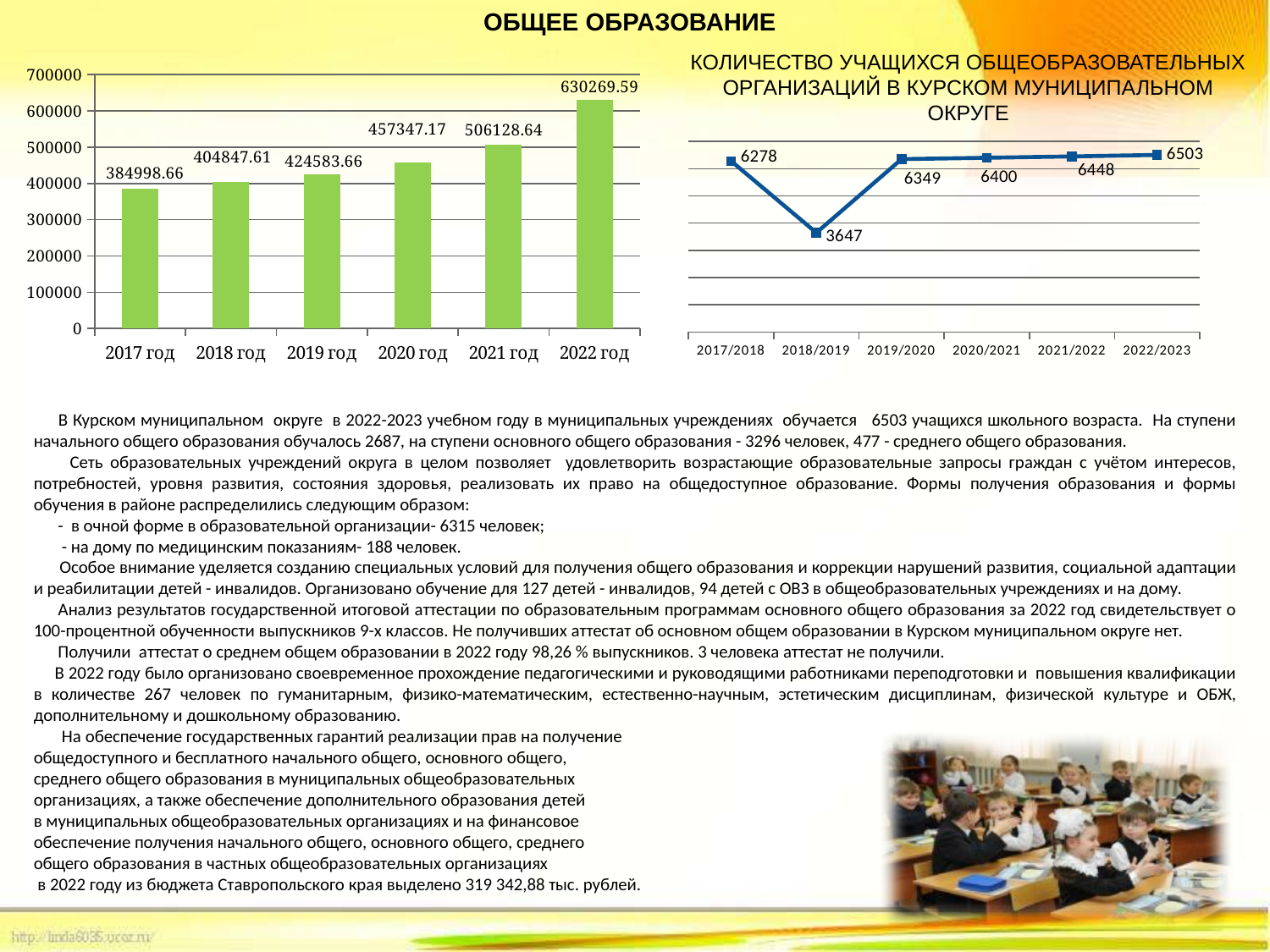
In the bar chart on the left, do the values rise or fall from 2017 год to 2022 год? rise In the chart titled 'КОЛИЧЕСТВО УЧАЩИХСЯ ОБЩЕОБРАЗОВАТЕЛЬНЫХ ОРГАНИЗАЦИЙ В КУРСКОМ МУНИЦИПАЛЬНОМ ОКРУГЕ', what is the value for 2018/2019? 3647 In the chart titled 'КОЛИЧЕСТВО УЧАЩИХСЯ ОБЩЕОБРАЗОВАТЕЛЬНЫХ ОРГАНИЗАЦИЙ В КУРСКОМ МУНИЦИПАЛЬНОМ ОКРУГЕ', which school year has the lowest value? 2018/2019 In the bar chart on the left, what is the difference between the values for 2022 год and 2021 год? 124140.95 In the bar chart on the left, what is the value for 2022 год? 630269.59 In the bar chart on the left, how many years are shown? 6 What kind of chart is the chart titled 'КОЛИЧЕСТВО УЧАЩИХСЯ ОБЩЕОБРАЗОВАТЕЛЬНЫХ ОРГАНИЗАЦИЙ В КУРСКОМ МУНИЦИПАЛЬНОМ ОКРУГЕ'? line chart In the bar chart on the left, what is the value for 2017 год? 384998.66 In the bar chart on the left, which year has the lowest value? 2017 год What kind of chart is the chart on the left? bar chart In the chart titled 'КОЛИЧЕСТВО УЧАЩИХСЯ ОБЩЕОБРАЗОВАТЕЛЬНЫХ ОРГАНИЗАЦИЙ В КУРСКОМ МУНИЦИПАЛЬНОМ ОКРУГЕ', what is the difference between the values for 2022/2023 and 2017/2018? 225 In the bar chart on the left, which year has the highest value? 2022 год